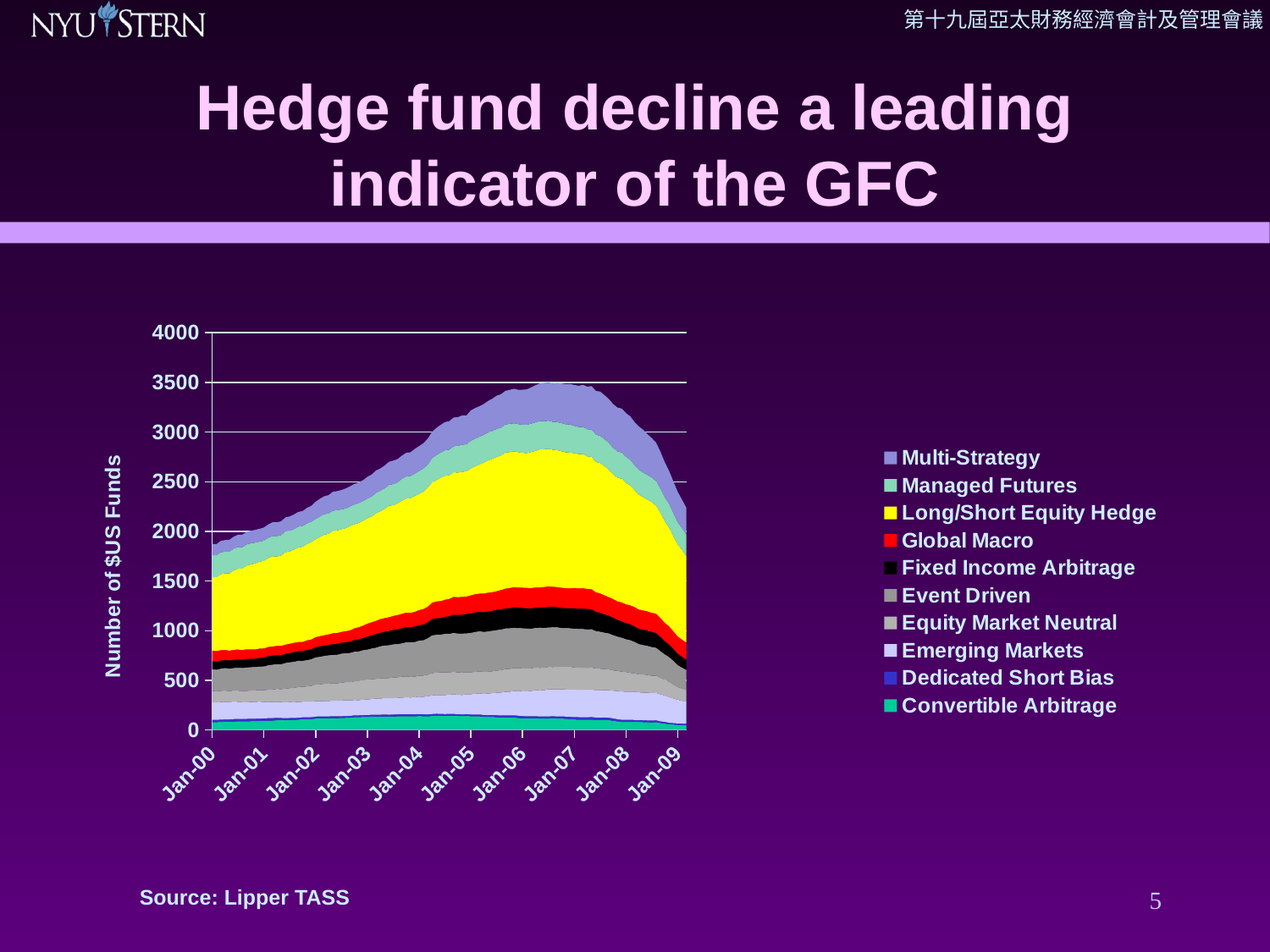
What is the label on the y axis of the chart? Number of $US Funds How many series does the legend list? 10 Does the total number of funds rise or fall from Jan-00 to Jan-07? rise Is the total number of funds at Jan-02 greater or less than 3000? less Among the labelled x-axis dates, at which date is the total number of funds highest? Jan-07 What kind of chart is shown on the slide? Stacked area chart How many labelled points are there on the x axis? 10 Is the total number of funds at Jan-04 greater or less than 2500? greater Which series accounts for the largest number of funds throughout the period? Long/Short Equity Hedge Is the total number of funds at Jan-09 greater or less than 2500? less Does the total number of funds rise or fall from Jan-07 to Jan-09? fall